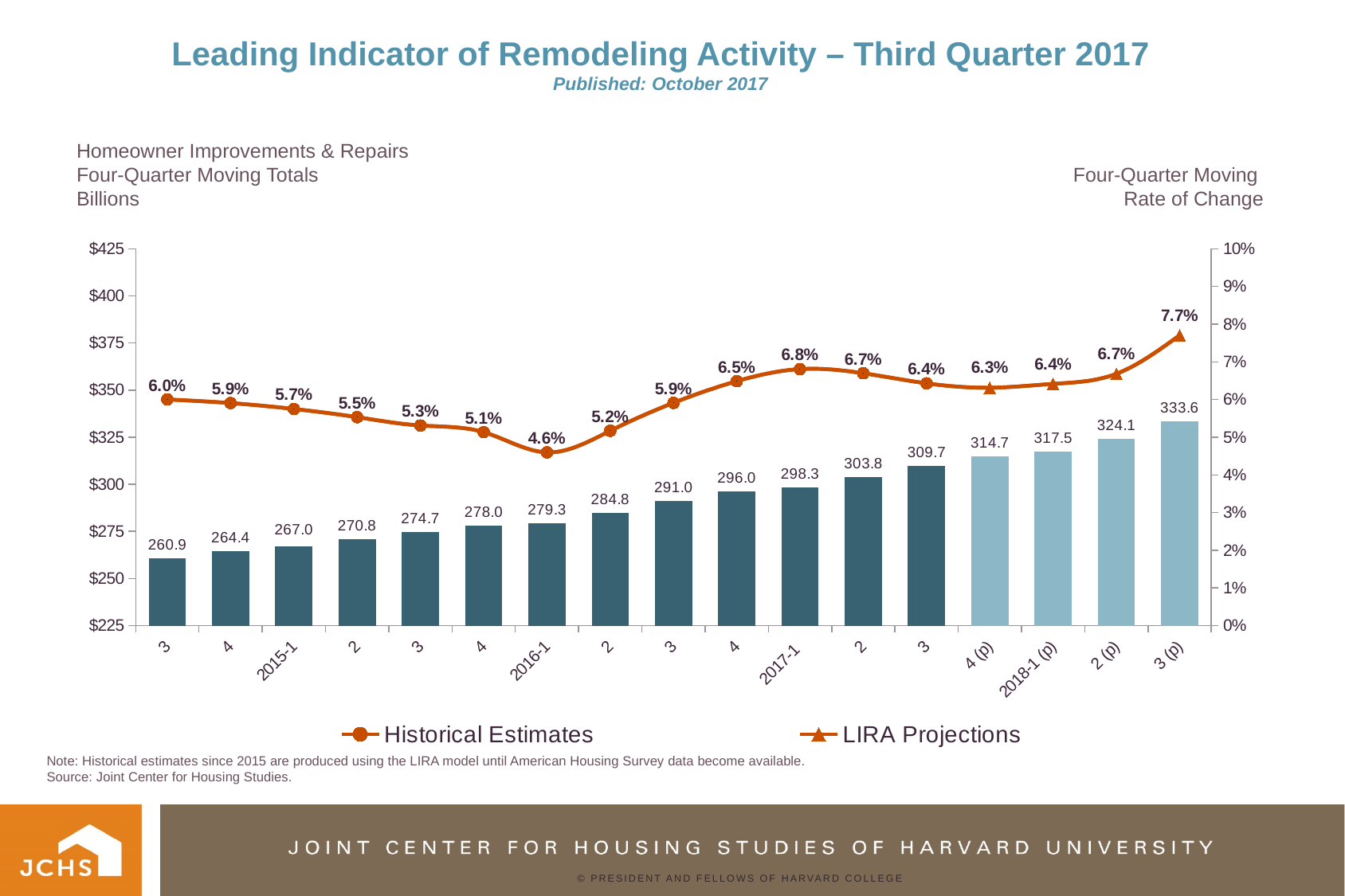
What is the difference between the four-quarter moving totals for 2018 quarter 3 (p) and 2017 quarter 3? 23.9 How many quarters (bars) are shown on the chart? 17 What are the two series named in the legend? Historical Estimates and LIRA Projections Which is larger, the rate of change for 2017-1 or for 2017 quarter 3? 2017-1 Is the four-quarter moving total for 2016 quarter 2 greater or less than $300? less Which quarter has the lowest four-quarter moving rate of change? 2016-1 What is the projected four-quarter moving total for 2018 quarter 3 (p)? 333.6 Which quarter has the highest four-quarter moving rate of change? 3 (p) of 2018 How many series does the legend list? 2 What is the four-quarter moving rate of change for 2016-1? 4.6% Do the four-quarter moving totals rise or fall from left to right across the chart? rise What is the four-quarter moving total (in billions) for 2017-1? 298.3